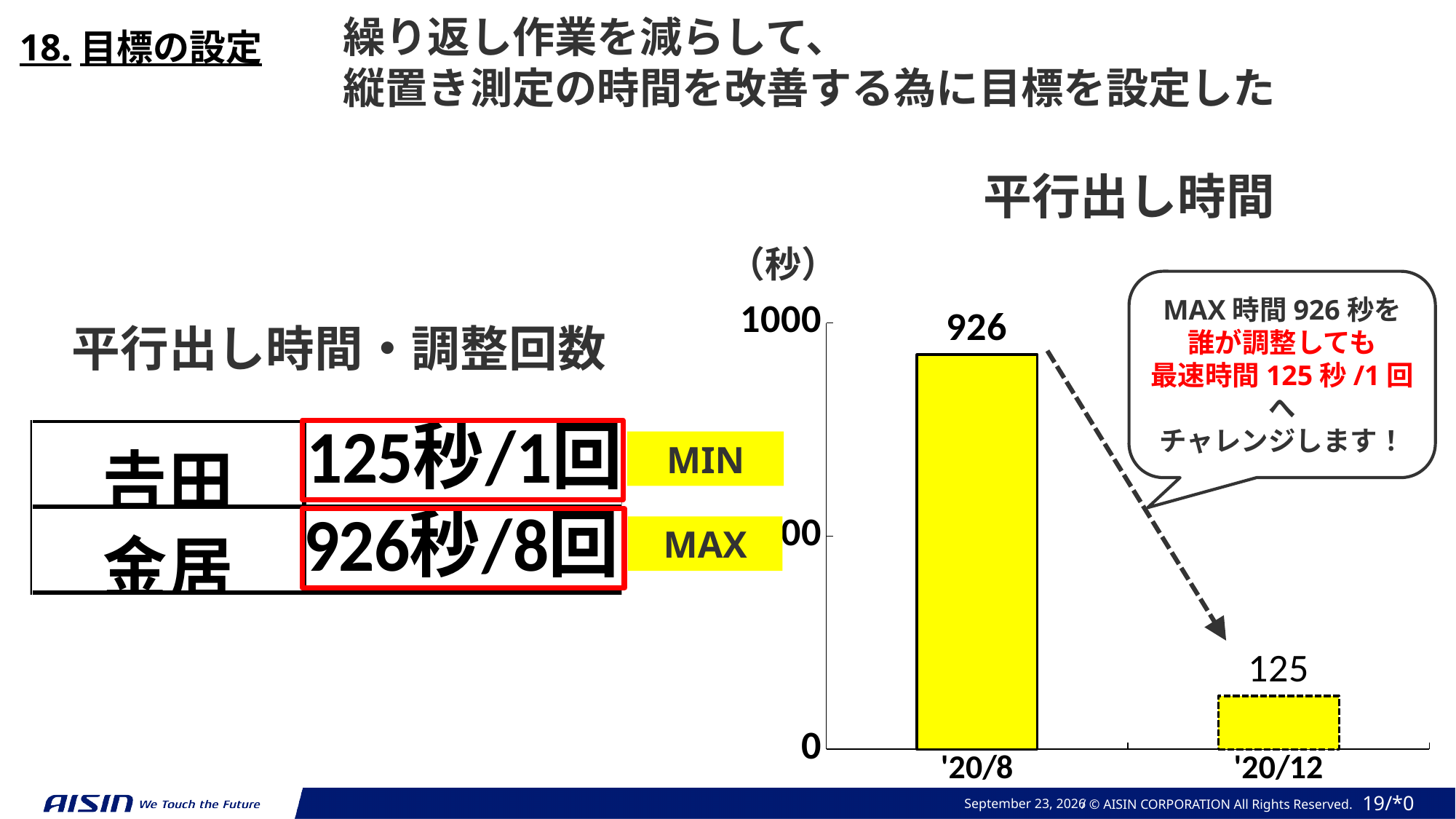
What is the value for '20/8 in the 平行出し時間 chart? 926 What kind of chart is the 平行出し時間 chart? bar chart What is the title of the chart on the slide? 平行出し時間 Which category has the lowest value in the 平行出し時間 chart? '20/12 How many bars are plotted in the 平行出し時間 chart? 2 Do the values in the 平行出し時間 chart rise or fall from '20/8 to '20/12? fall What is the difference between the '20/8 and '20/12 values in the 平行出し時間 chart? 801 What is the value for '20/12 in the 平行出し時間 chart? 125 Is the value for '20/12 in the 平行出し時間 chart greater or less than 1000? less Which category has the highest value in the 平行出し時間 chart? '20/8 In the 平行出し時間 chart, which is larger, the value for '20/8 or the value for '20/12? '20/8 What unit is shown on the y axis of the 平行出し時間 chart? 秒